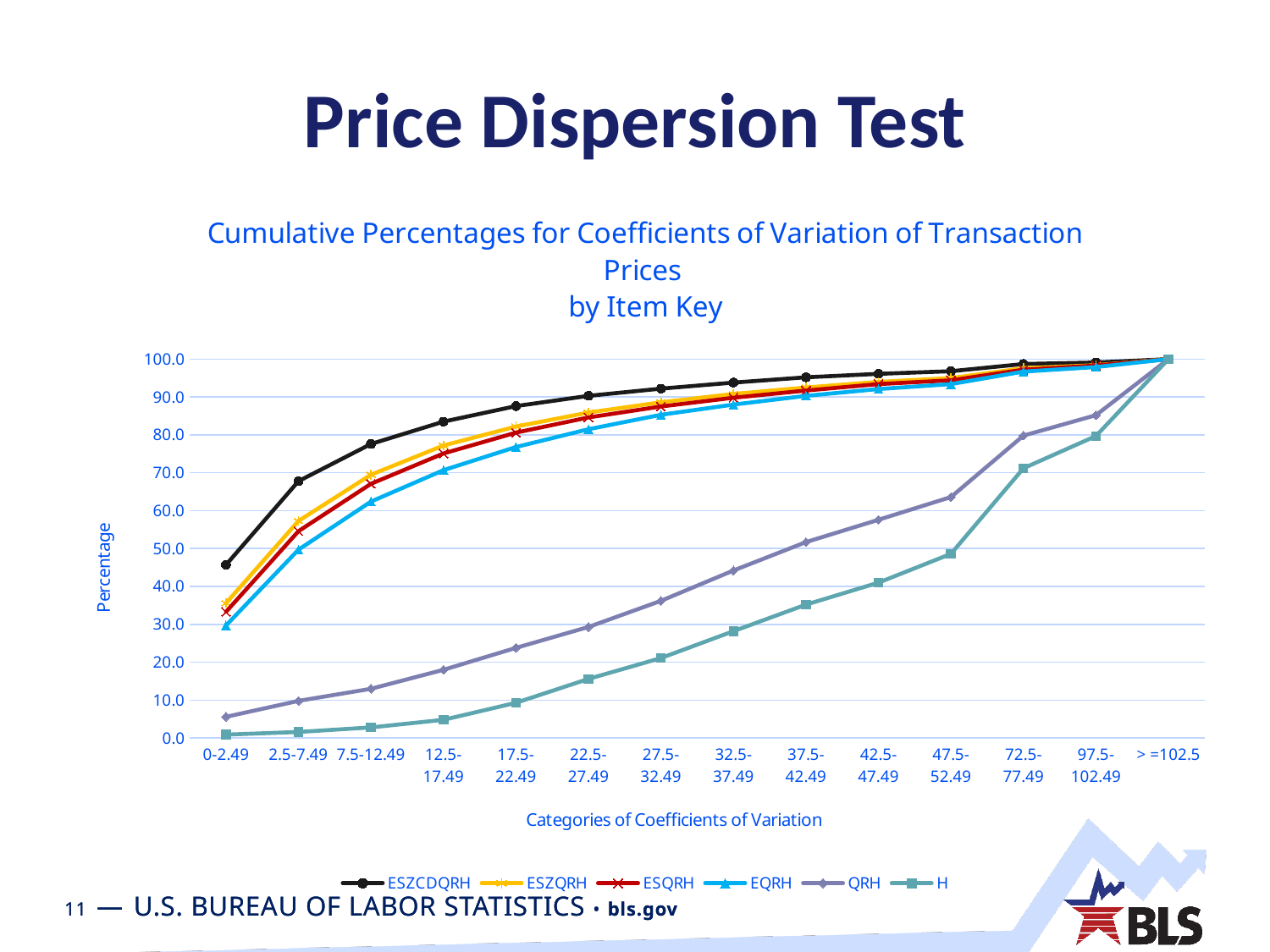
How many series does the legend list? 6 What kind of chart is shown on the slide? line chart Which series has the highest value in the 0-2.49 category? ESZCDQRH What is the label on the y axis of the chart? Percentage Is the value for EQRH in the 7.5-12.49 category greater or less than 60? greater Is the value for QRH in the 47.5-52.49 category greater or less than 60? greater Is the value for ESZCDQRH in the 0-2.49 category greater or less than 50? less Do the values for the H series rise or fall as you move along the x axis? rise Which series has the lowest value in the 0-2.49 category? H How many categories are shown along the x axis? 14 In the 47.5-52.49 category, which series has the larger value, QRH or H? QRH